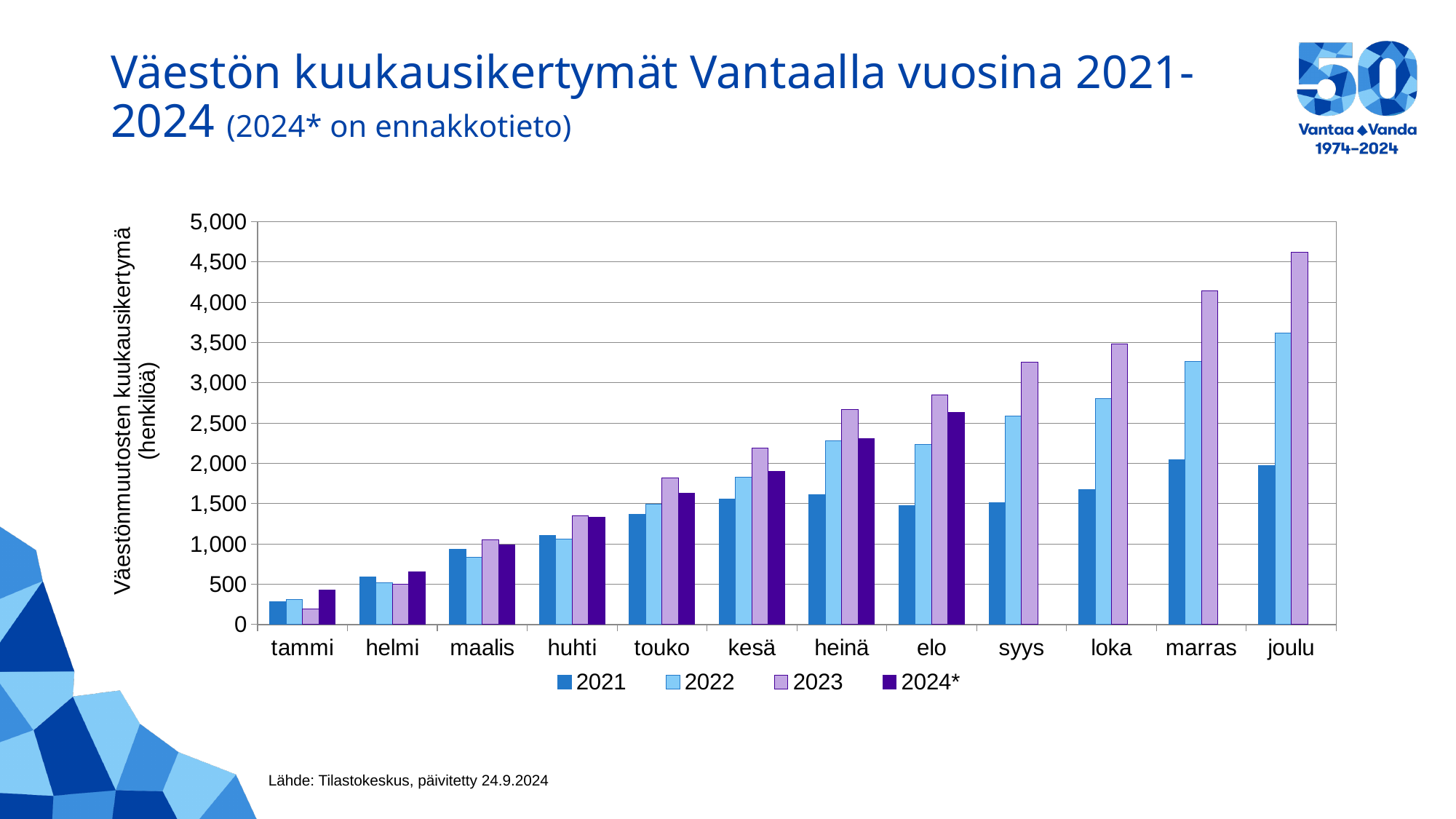
How many months are shown on the x axis? 12 Do the 2023 values rise or fall from tammi to joulu? rise Which series has no bars for the months syys through joulu? 2024* Is the 2022 value for joulu greater or less than 3,500? greater Is the 2023 value for joulu greater or less than 4,500? greater What kind of chart is shown on the slide? bar chart Is the 2021 value for heinä greater or less than 1,500? greater In which month is the 2023 value highest? joulu For tammi, which is larger: the 2021 value or the 2024* value? 2024* In which month is the 2023 value lowest? tammi For syys, which is larger: the 2022 value or the 2023 value? 2023 How many series does the legend list? 4